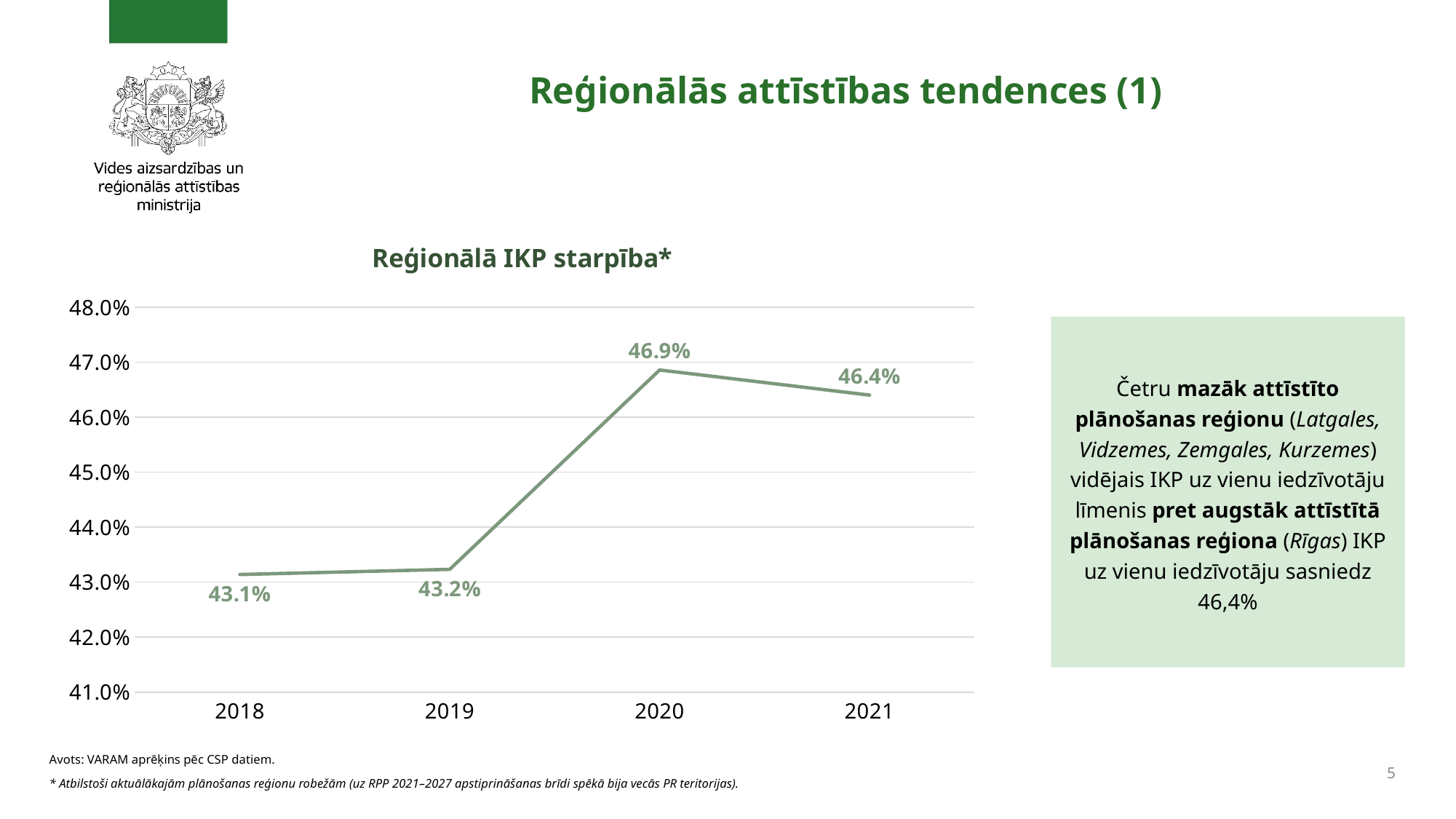
What is the title of the chart? Reģionālā IKP starpība* What is the value for 2021? 46.4% Which year has the highest value? 2020 What is the difference between the values for 2021 and 2018? 3.3% What is the value for 2018? 43.1% Which year has the lowest value? 2018 How many years are plotted on the chart? 4 What is the difference between the values for 2020 and 2019? 3.7% What is the value for 2020? 46.9% Is the value for 2020 greater or less than 46.0%? greater What kind of chart is shown on the slide? line chart Which is larger, the value for 2019 or the value for 2021? 2021